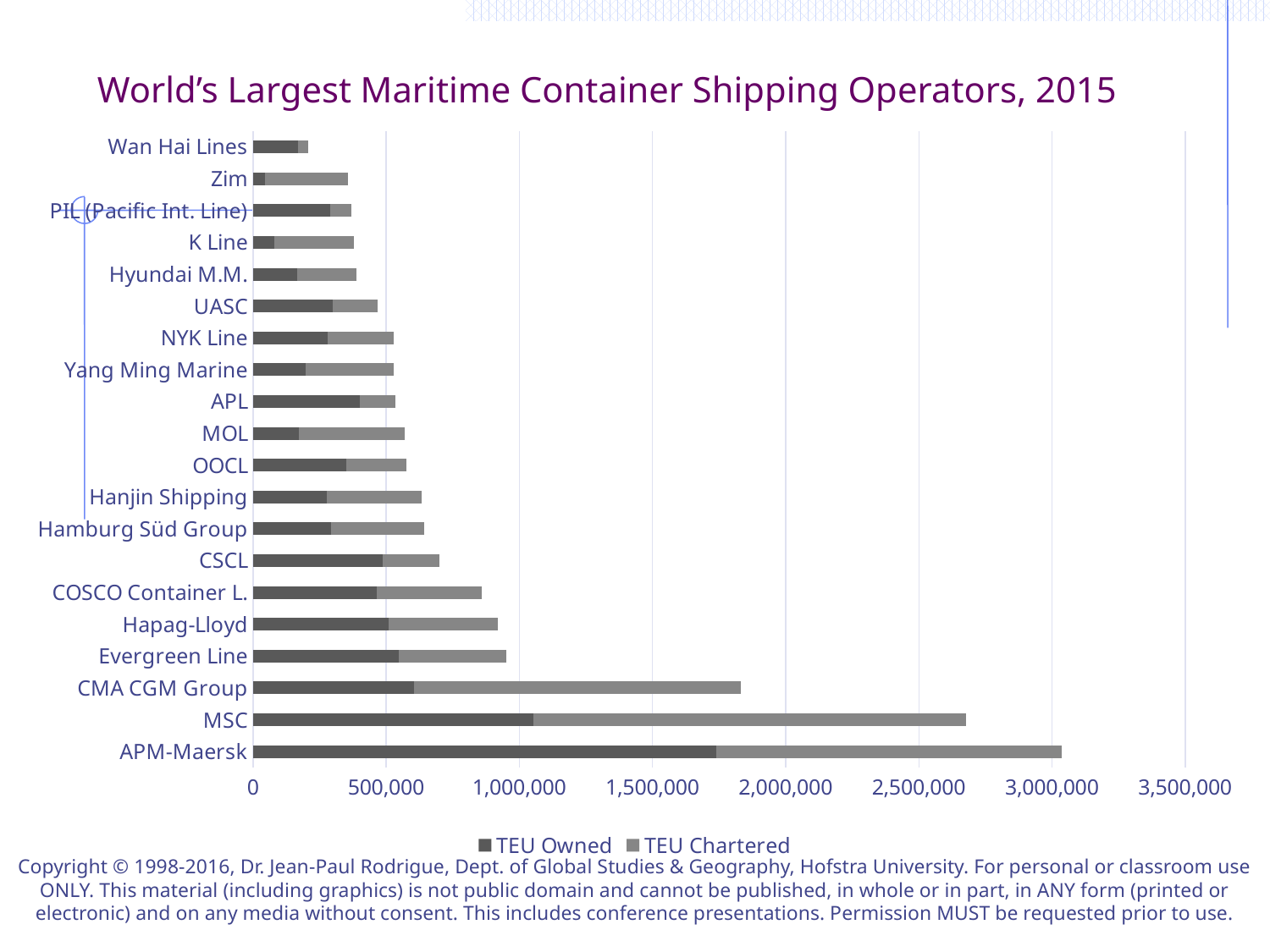
Is the total TEU for MSC greater or less than 2,500,000? greater What are the two series named in the legend? TEU Owned and TEU Chartered Which operator has the smallest total TEU capacity? Wan Hai Lines Is the total TEU for CMA CGM Group greater or less than 2,000,000? less Which operator has the largest total TEU capacity? APM-Maersk How many shipping operators are listed on the chart? 20 What is the title of the chart? World's Largest Maritime Container Shipping Operators, 2015 Which has a larger total TEU capacity, COSCO Container L. or CSCL? COSCO Container L. Which operator has more TEU Owned, APM-Maersk or MSC? APM-Maersk Is the total TEU for Evergreen Line greater or less than 1,000,000? less What kind of chart is shown on the slide? Stacked bar chart How many series does the legend list? 2